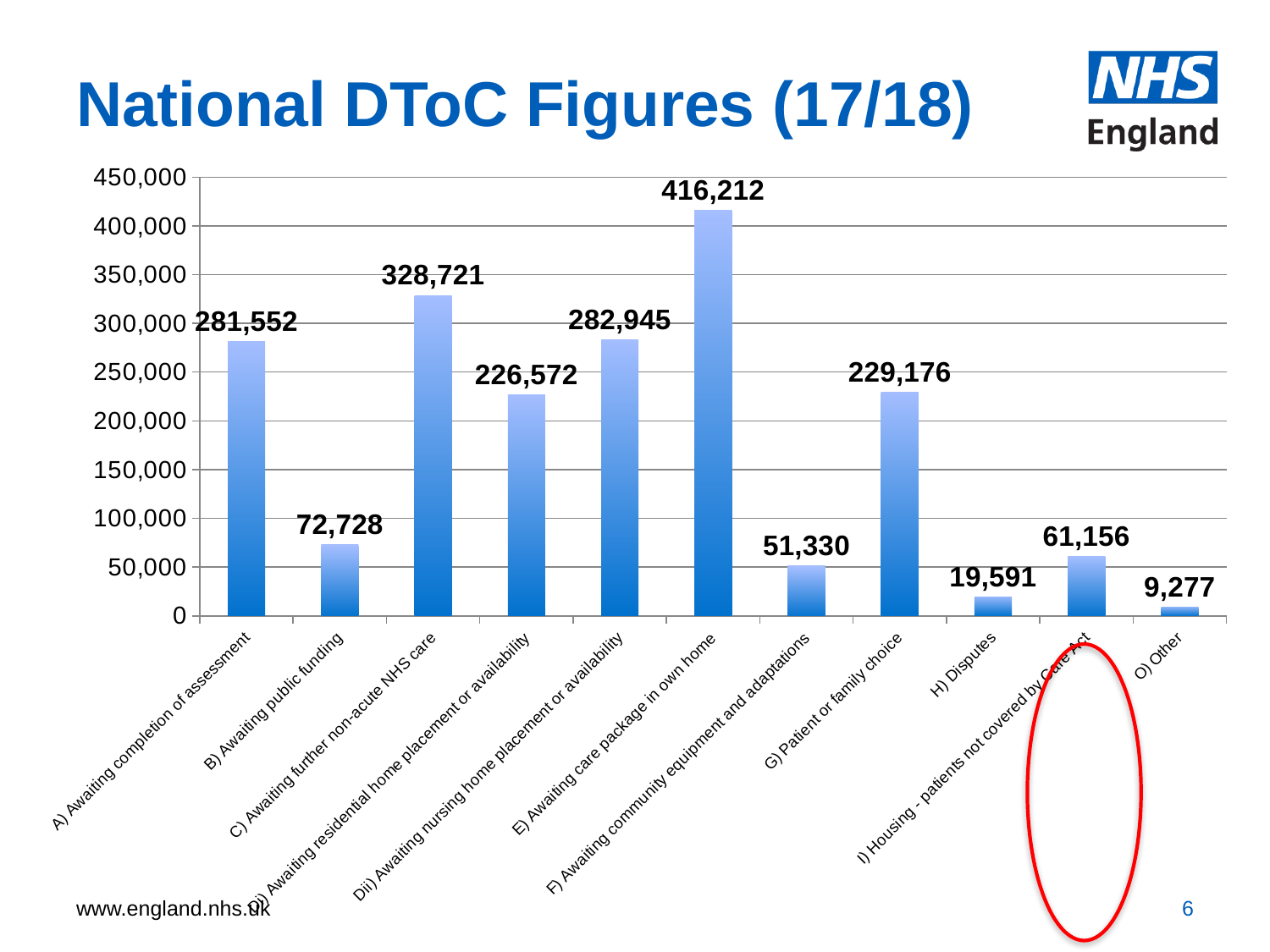
What is the title of the slide? National DToC Figures (17/18) What is the value for I) Housing - patients not covered by Care Act? 61,156 How many categories are shown in the chart? 11 Which category has the lowest value? O) Other Which is larger, the value for Dii) Awaiting nursing home placement or availability or the value for Di) Awaiting residential home placement or availability? Dii) Awaiting nursing home placement or availability What is the value for E) Awaiting care package in own home? 416,212 What is the value for G) Patient or family choice? 229,176 What is the difference between the values for C) Awaiting further non-acute NHS care and A) Awaiting completion of assessment? 47,169 What kind of chart is shown on the slide? Bar chart What is the difference between the values for B) Awaiting public funding and F) Awaiting community equipment and adaptations? 21,398 Which category has the highest value? E) Awaiting care package in own home What is the value for H) Disputes? 19,591